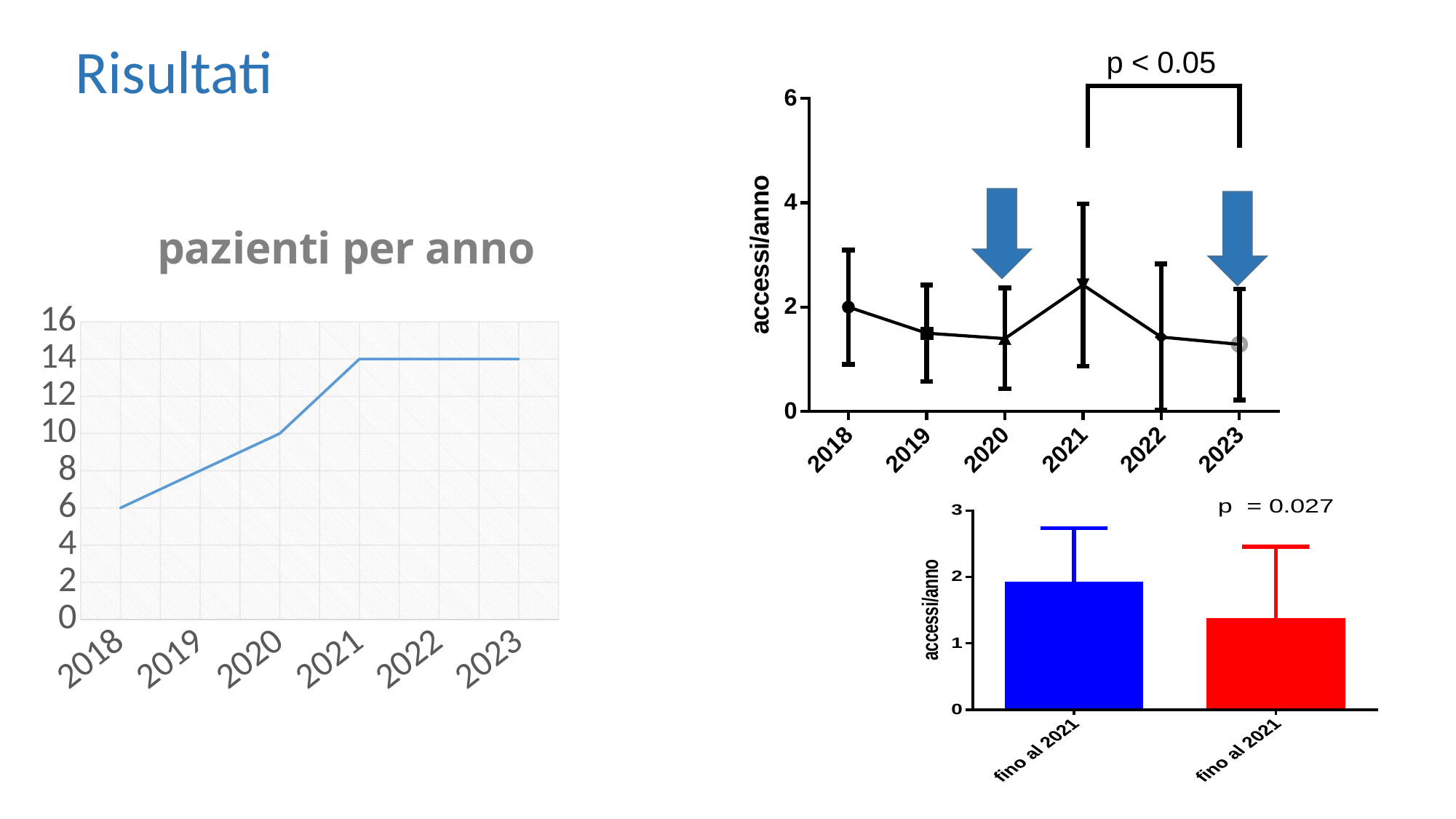
What kind of chart is the 'pazienti per anno' chart? line chart In the 'pazienti per anno' chart, what is the value for 2020? 10 In the 'pazienti per anno' chart, do the values rise or fall from 2018 to 2021? rise In the bottom-right bar chart, is the blue bar or the red bar taller? blue bar In the 'pazienti per anno' chart, what is the value for 2018? 6 How many years are shown on the x axis of the 'pazienti per anno' chart? 6 In the 'pazienti per anno' chart, which year has the lowest value? 2018 In the top-right 'accessi/anno' chart, what is the value for 2018? 2 In the top-right 'accessi/anno' chart, which year has the highest value? 2021 In the 'pazienti per anno' chart, what is the difference between the values for 2021 and 2018? 8 In the top-right 'accessi/anno' chart, is the value for 2021 greater or less than 2? greater In the 'pazienti per anno' chart, what is the value for 2021? 14